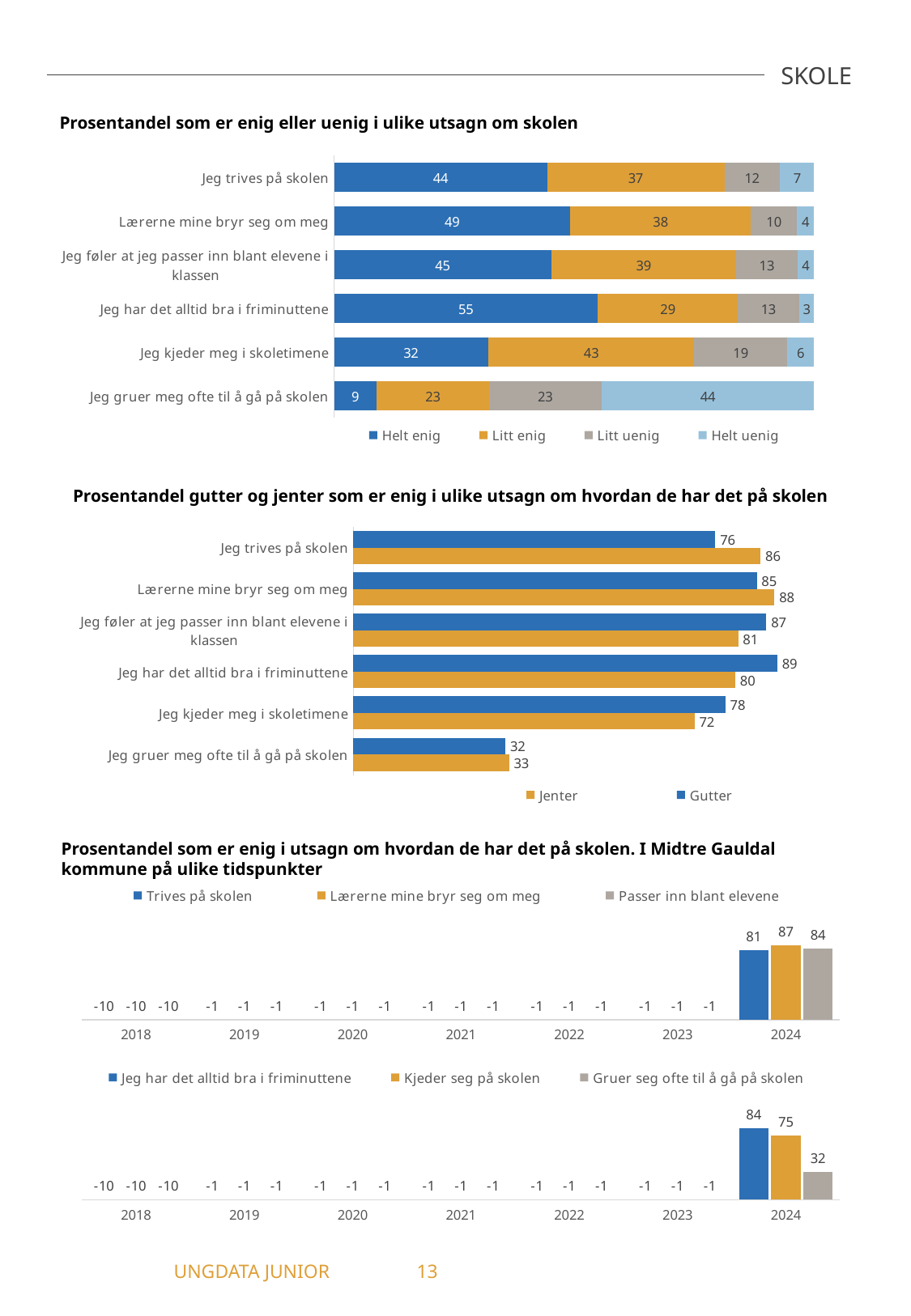
In the chart 'Prosentandel som er enig eller uenig i ulike utsagn om skolen', what is the 'Helt enig' value for 'Jeg har det alltid bra i friminuttene'? 55 In the second chart under 'Prosentandel som er enig i utsagn om hvordan de har det på skolen. I Midtre Gauldal kommune på ulike tidspunkter', which series has the lowest 2024 value? Gruer seg ofte til å gå på skolen In the chart 'Prosentandel gutter og jenter som er enig i ulike utsagn om hvordan de har det på skolen', which is larger for 'Jeg kjeder meg i skoletimene': 'Gutter' or 'Jenter'? Gutter In the chart 'Prosentandel som er enig eller uenig i ulike utsagn om skolen', what is the total of the stacked bar for 'Jeg trives på skolen'? 100 In the chart 'Prosentandel som er enig eller uenig i ulike utsagn om skolen', which statement has the highest 'Helt enig' value? Jeg har det alltid bra i friminuttene In the chart 'Prosentandel gutter og jenter som er enig i ulike utsagn om hvordan de har det på skolen', what is the difference between 'Gutter' and 'Jenter' for 'Jeg har det alltid bra i friminuttene'? 9 In the chart 'Prosentandel som er enig eller uenig i ulike utsagn om skolen', how many series does the legend list? 4 In the chart 'Prosentandel gutter og jenter som er enig i ulike utsagn om hvordan de har det på skolen', how many statements are shown? 6 In the first chart under 'Prosentandel som er enig i utsagn om hvordan de har det på skolen. I Midtre Gauldal kommune på ulike tidspunkter', what is the 2024 value for 'Lærerne mine bryr seg om meg'? 87 In the chart 'Prosentandel som er enig eller uenig i ulike utsagn om skolen', what is the 'Helt uenig' value for 'Jeg gruer meg ofte til å gå på skolen'? 44 In the chart 'Prosentandel gutter og jenter som er enig i ulike utsagn om hvordan de har det på skolen', what is the 'Jenter' value for 'Jeg trives på skolen'? 86 What kind of chart is 'Prosentandel gutter og jenter som er enig i ulike utsagn om hvordan de har det på skolen'? Bar chart